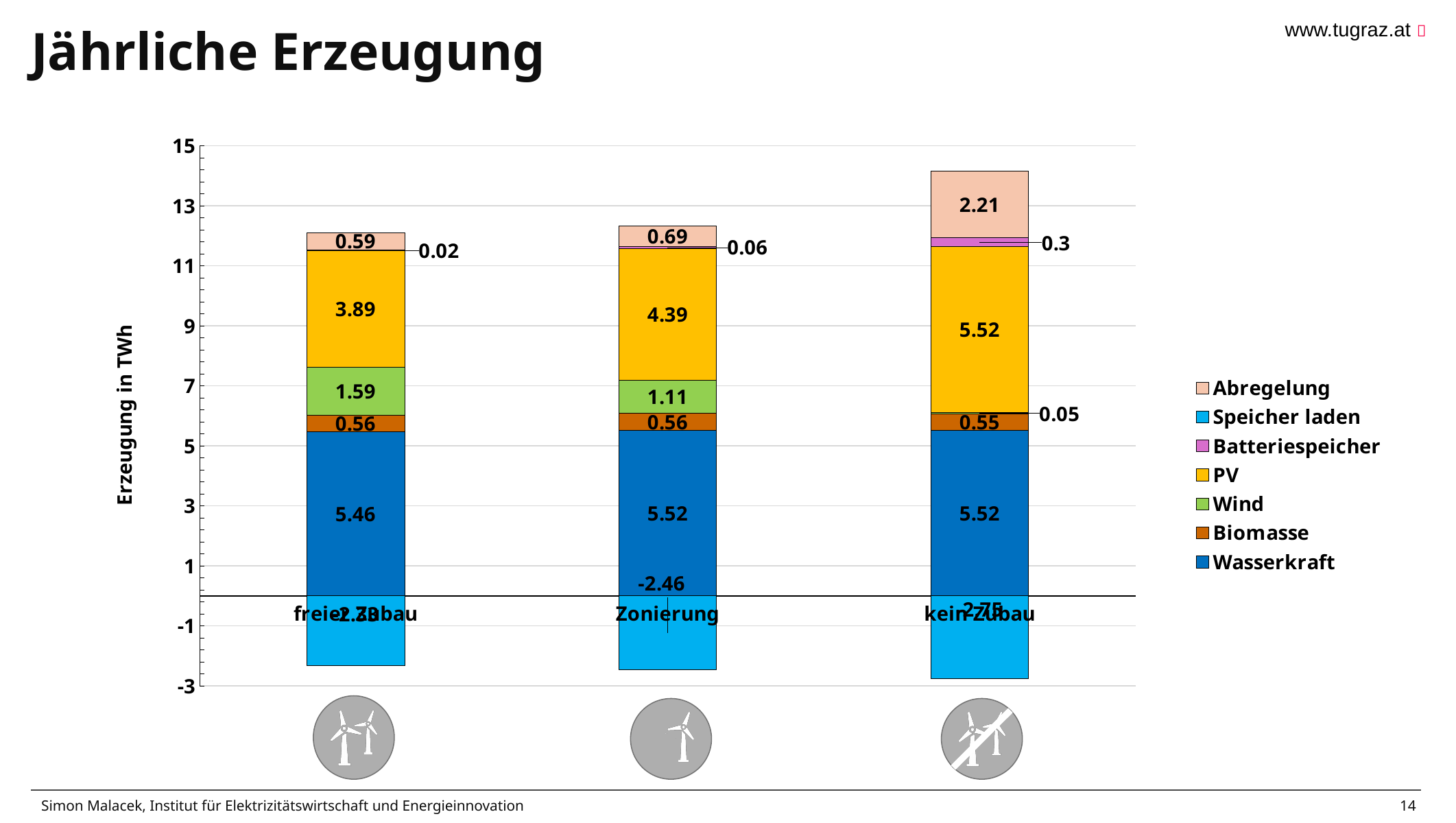
What kind of chart is shown on the slide? Stacked bar chart How many categories are shown on the x axis? 3 Which category has the lowest PV value? freier Zubau What is the PV value for the "Zonierung" bar? 4.39 What is the Wind value for the "freier Zubau" bar? 1.59 What is the difference between the PV values for "kein Zubau" and "freier Zubau"? 1.63 Which is larger: the Wind value for "freier Zubau" or for "Zonierung"? freier Zubau Which category has the highest Abregelung value? kein Zubau What is the Batteriespeicher value for the "kein Zubau" bar? 0.3 What is the Speicher laden value for the "Zonierung" bar? -2.46 How many series does the legend list? 7 What is the Abregelung value for the "kein Zubau" bar? 2.21